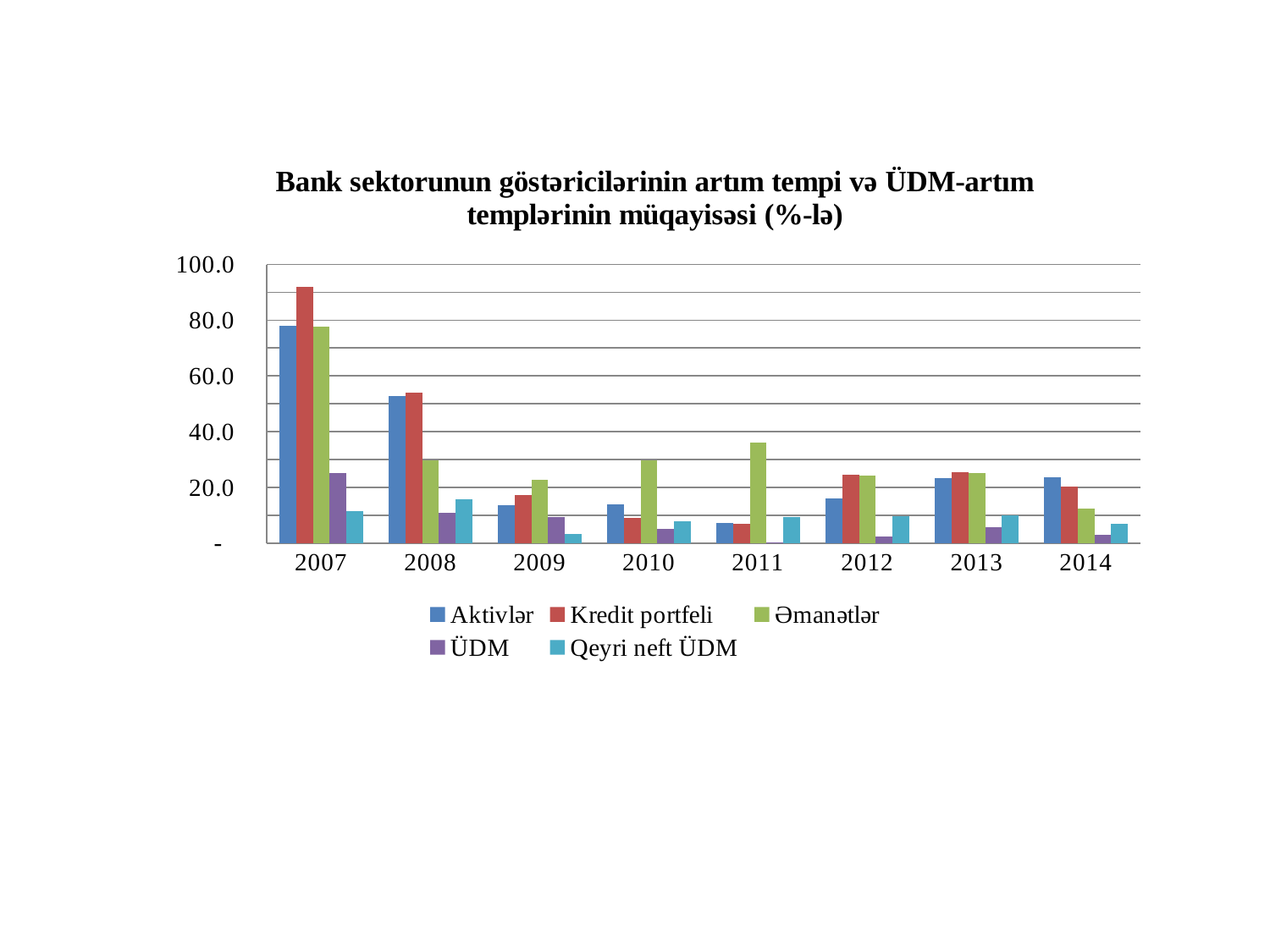
Is the Kredit portfeli value for 2007 greater or less than 80.0? greater How many years are shown on the x axis? 8 Does the Aktivlər value rise or fall from 2007 to 2011? Fall How many series does the legend list? 5 What kind of chart is shown on the slide? Bar chart Is the Aktivlər value for 2008 greater or less than 40.0? greater Is the Əmanətlər value for 2011 greater or less than 20.0? greater In which year is the Kredit portfeli value highest? 2007 In 2010, which is larger: Əmanətlər or Aktivlər? Əmanətlər Which series has the lowest value in 2011? ÜDM In 2014, which is larger: Aktivlər or Kredit portfeli? Aktivlər What is the title of the chart? Bank sektorunun göstəricilərinin artım tempi və ÜDM-artım templərinin müqayisəsi (%-lə)